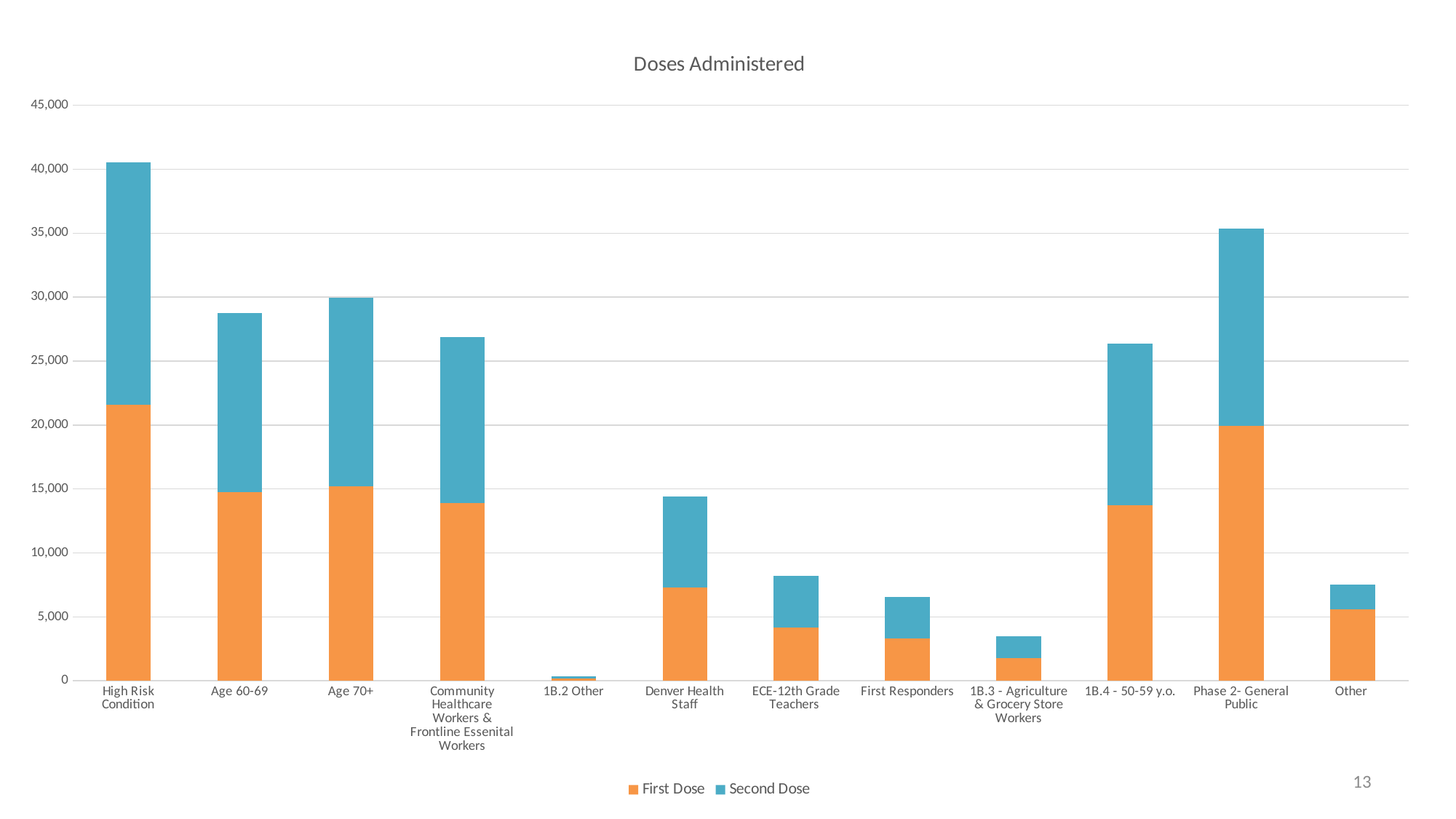
Is the total for Denver Health Staff greater or less than 15,000? less How many categories are shown on the x axis? 12 Which has a larger total, Phase 2- General Public or 1B.4 - 50-59 y.o.? Phase 2- General Public Which category has the highest total doses administered? High Risk Condition Is the First Dose value for High Risk Condition greater or less than 20,000? greater Which series is shown in orange? First Dose How many series does the legend list? 2 Is the total for High Risk Condition greater or less than 35,000? greater What kind of chart is shown on the slide? Stacked bar chart What is the title of the chart? Doses Administered Which category has the lowest total doses administered? 1B.2 Other